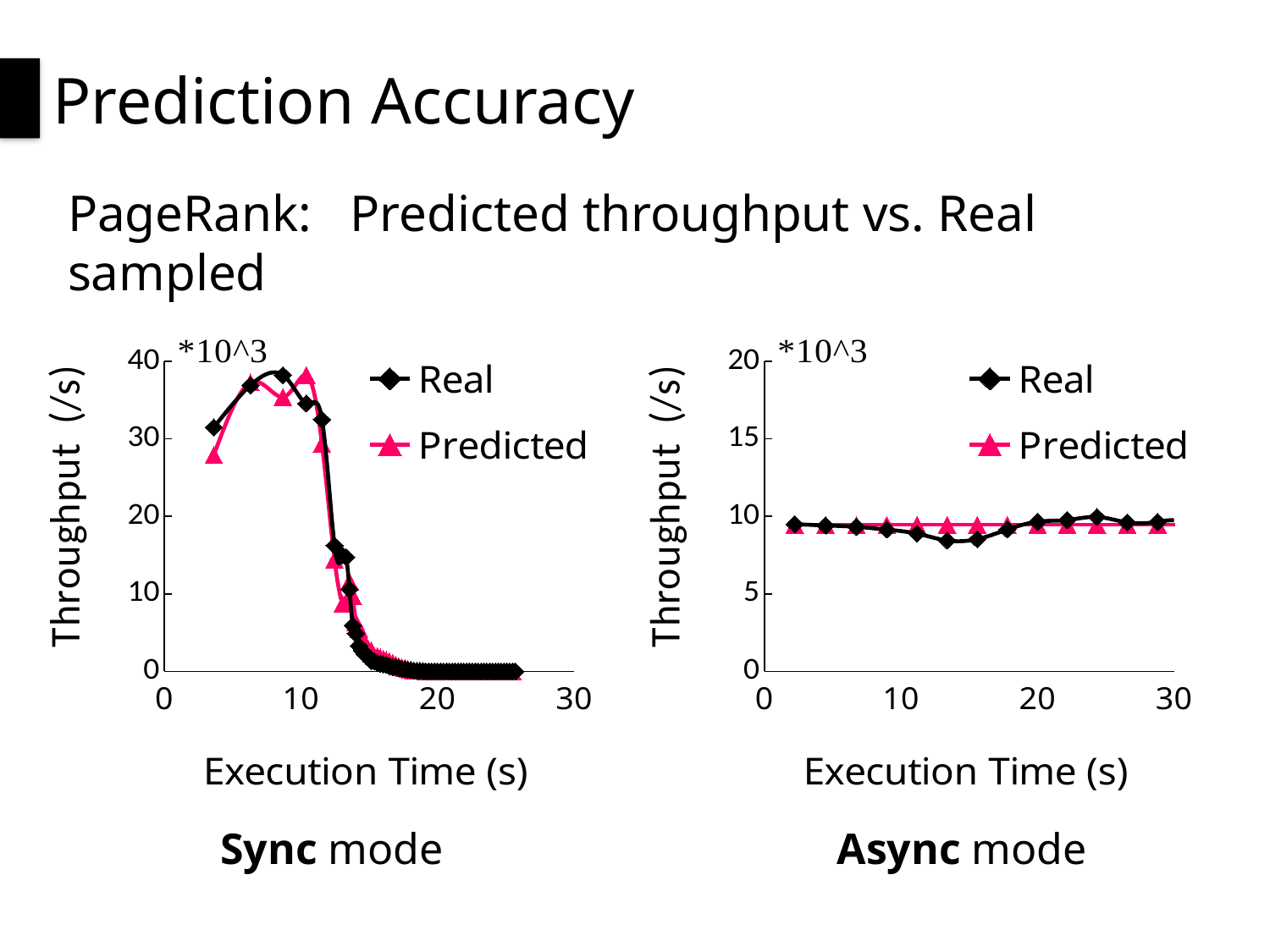
In the Async mode chart, is the Real throughput at execution time 10 s greater or less than 15 (*10^3)? less What is the maximum value shown on the y-axis of the Async mode chart? 20 In the Async mode chart, is the Predicted throughput at execution time 20 s greater or less than 5 (*10^3)? greater How many series does the legend of the Async mode chart list? 2 In the Sync mode chart, do the Real throughput values rise or fall between execution time 10 s and 20 s? fall In the Sync mode chart, is the peak value of the Real series greater or less than 30 (*10^3)? greater What are the two series named in the legend of the Sync mode chart? Real and Predicted What kind of chart is the Sync mode chart on the left? Line chart What kind of chart is the Async mode chart on the right? Line chart In the Sync mode chart, which series has the higher value at execution time 10 s, Real or Predicted? Predicted What is the x-axis title of the Async mode chart? Execution Time (s)